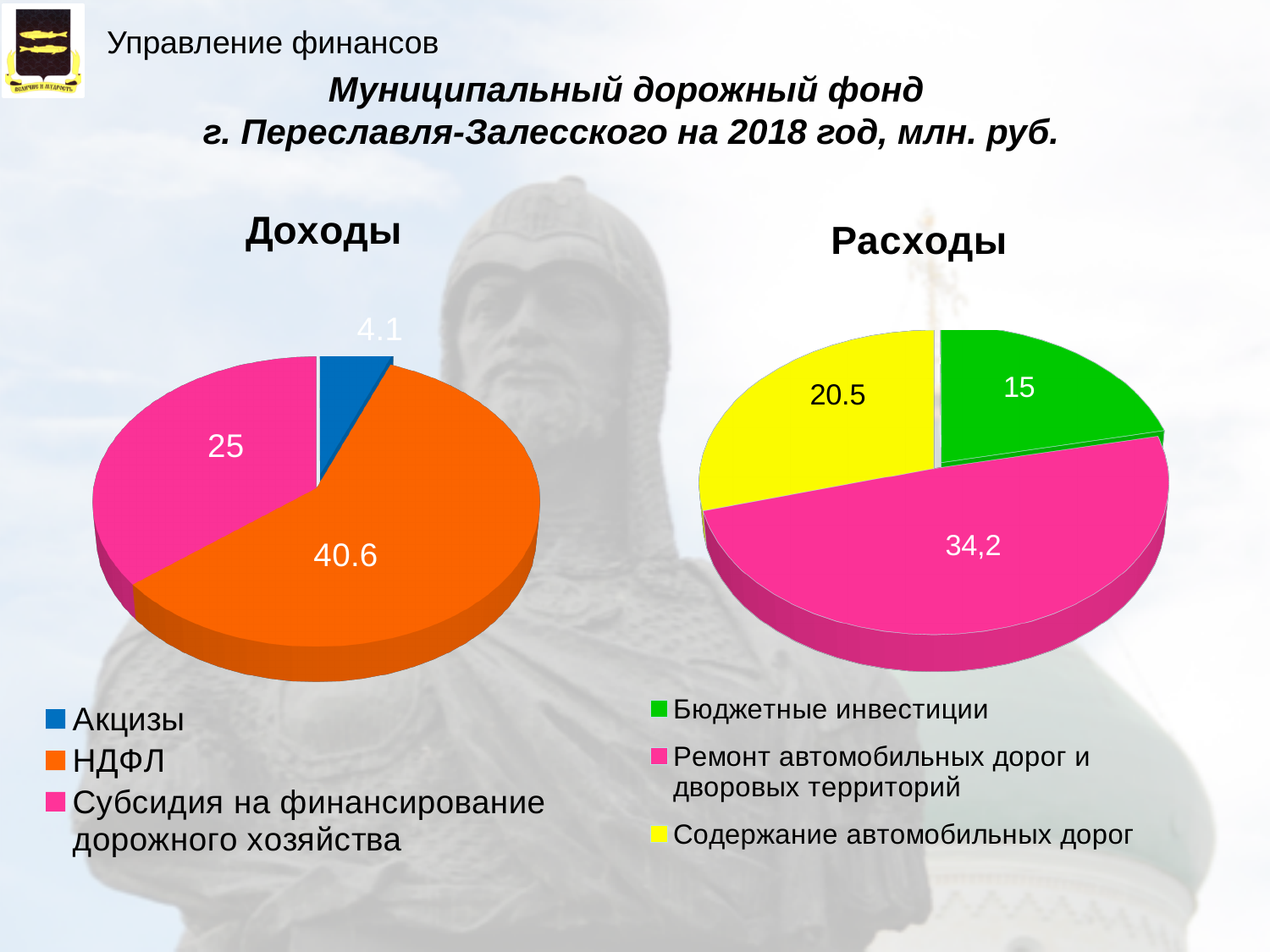
In the Расходы chart, which category has the smallest slice? Бюджетные инвестиции In the Доходы chart, what is the value for НДФЛ? 40.6 In the Расходы chart, what is the value for Содержание автомобильных дорог? 20.5 In the Доходы chart, which category has the largest slice? НДФЛ In the Расходы chart, what colour is the slice for Бюджетные инвестиции? Green What type of chart is the Доходы chart? Pie chart In the Расходы chart, which is larger: Бюджетные инвестиции or Содержание автомобильных дорог? Содержание автомобильных дорог In the Расходы chart, what is the value for Ремонт автомобильных дорог и дворовых территорий? 34,2 How many entries does the legend of the Доходы chart list? 3 How many slices does the Расходы chart have? 3 In the Доходы chart, what is the difference between НДФЛ and Субсидия на финансирование дорожного хозяйства? 15.6 In the Доходы chart, what is the value for Акцизы? 4.1